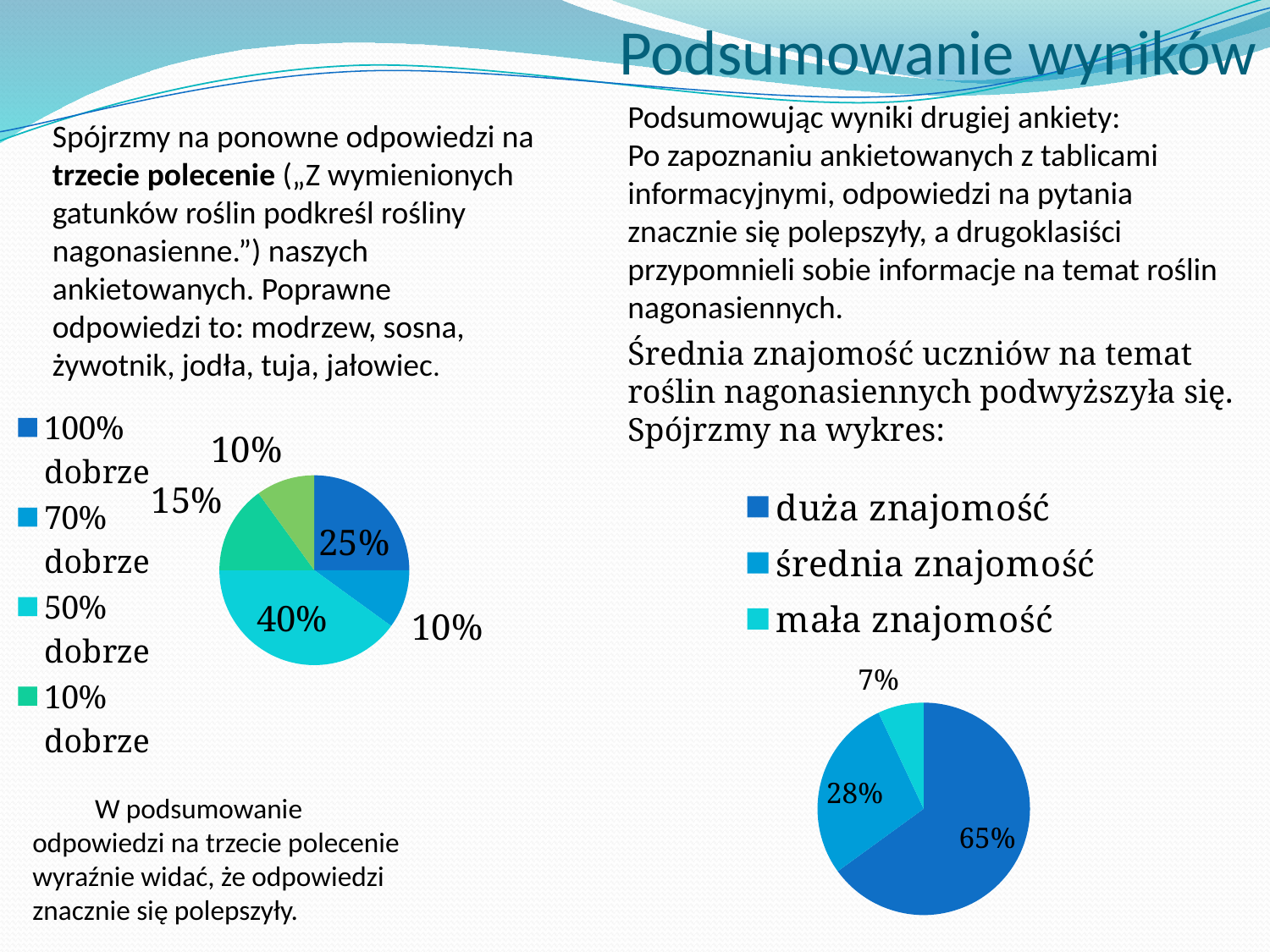
What kind of chart is the chart on the right side of the slide? pie chart On the right pie chart, which category has the largest slice? duża znajomość On the left pie chart, what share is labelled for '100% dobrze'? 25% On the right pie chart, what share is labelled for 'mała znajomość'? 7% On the right pie chart, what share is labelled for 'średnia znajomość'? 28% On the left pie chart, how many slices does the pie have? 5 On the right pie chart, how many entries does the legend list? 3 On the left pie chart, which category has the largest slice? 50% dobrze On the left pie chart, what share is labelled for '50% dobrze'? 40% On the right pie chart, which category has the smallest slice? mała znajomość On the right pie chart, what is the difference between the shares for 'duża znajomość' and 'średnia znajomość'? 37% On the right pie chart, what share is labelled for 'duża znajomość'? 65%